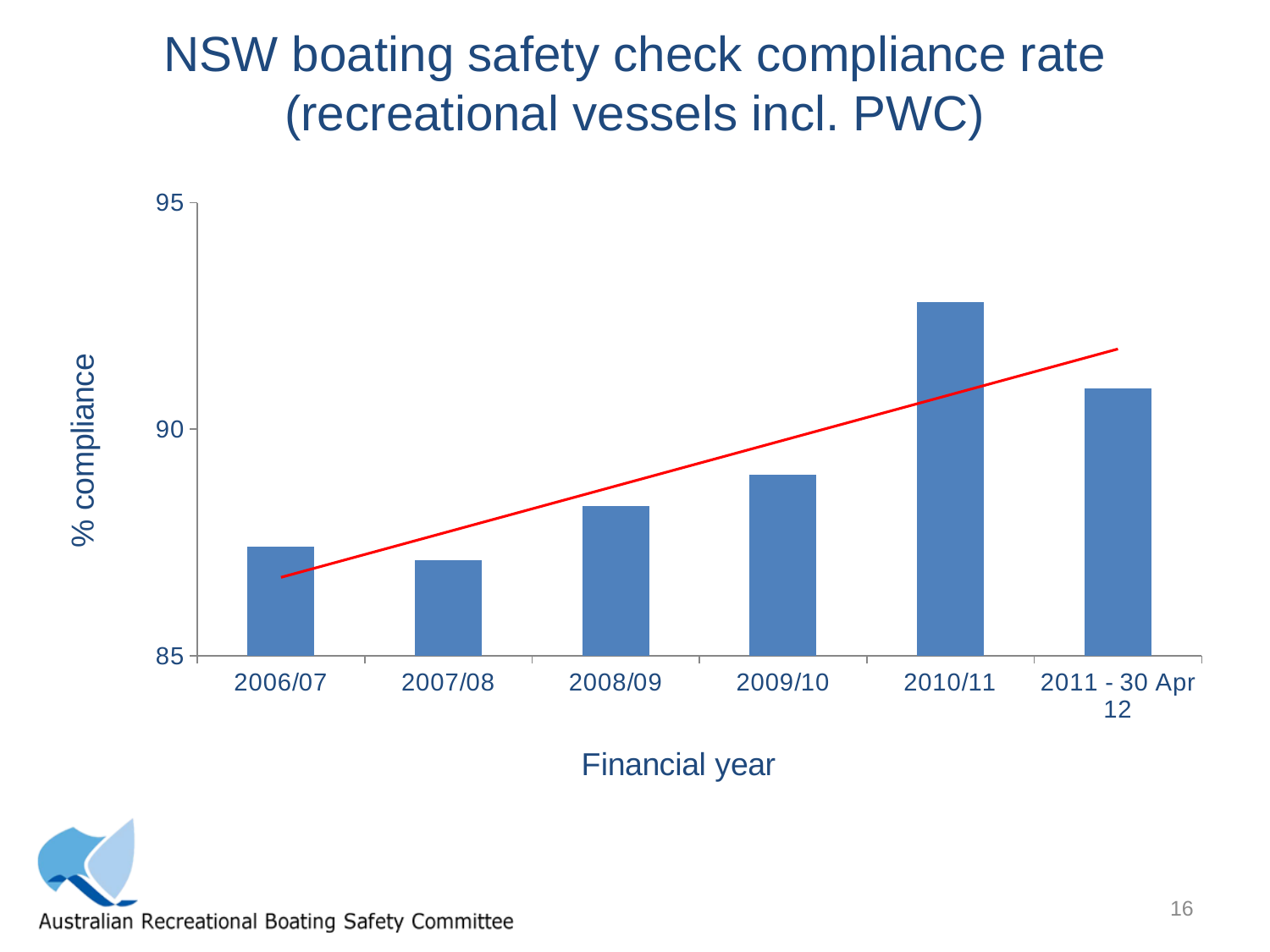
What kind of chart is shown on the slide? Bar chart Which is larger, the value for 2010/11 or the value for 2011 - 30 Apr 12? 2010/11 Is the value for 2010/11 greater or less than 90? greater Which financial year has the highest compliance rate? 2010/11 Which is larger, the value for 2008/09 or the value for 2009/10? 2009/10 Is the value for 2011 - 30 Apr 12 greater or less than 90? greater Is the value for 2009/10 greater or less than 90? less How many financial year categories are plotted on the x axis? 6 Which financial year has the lowest compliance rate? 2007/08 Does the compliance rate generally rise or fall across the financial years shown? Rise What is the label on the y axis of the chart? % compliance